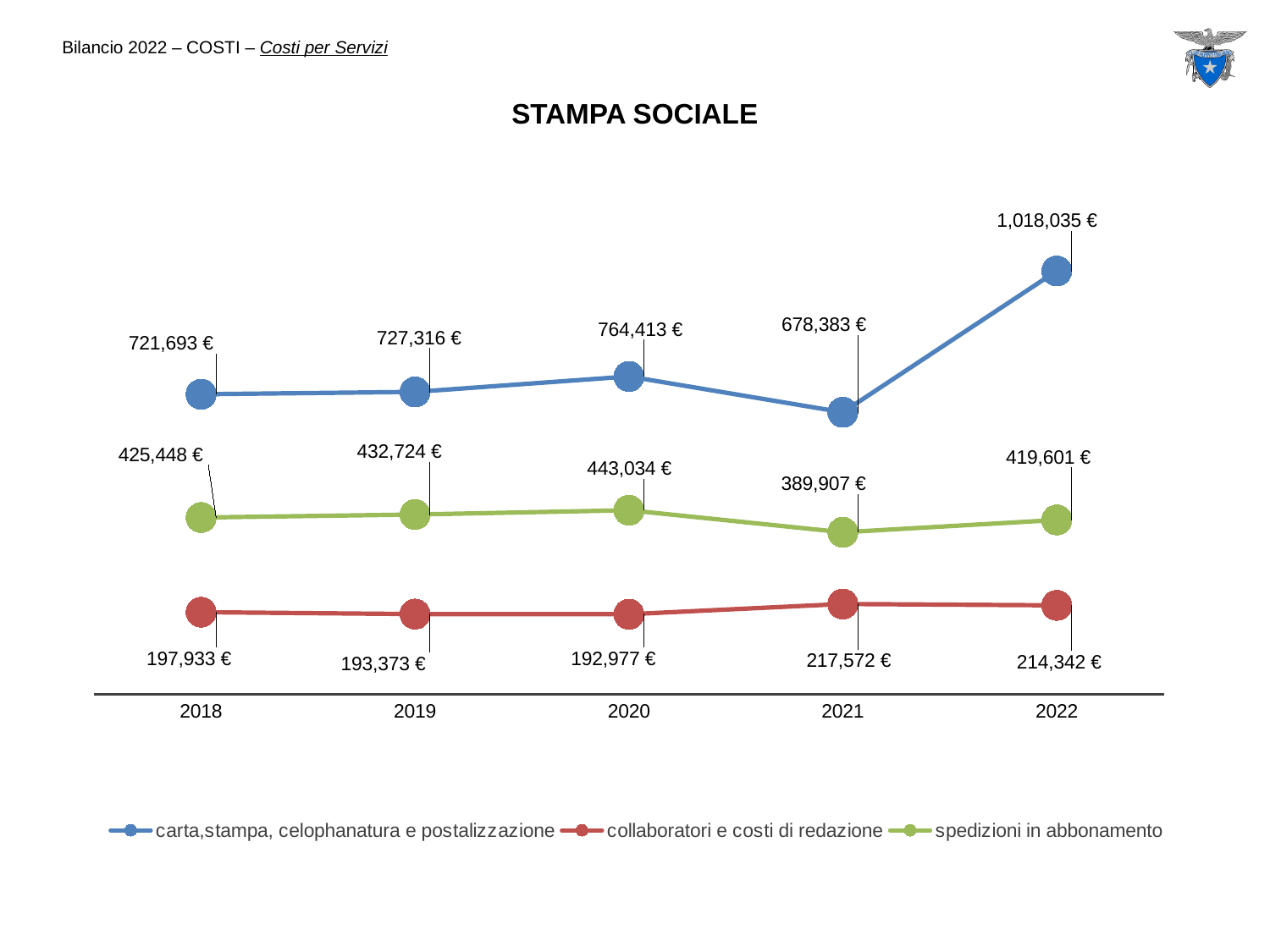
What is the difference between the 2022 and 2021 values for 'carta,stampa, celophanatura e postalizzazione'? 339,652 € Does 'carta,stampa, celophanatura e postalizzazione' rise or fall from 2021 to 2022? Rise In which year is 'carta,stampa, celophanatura e postalizzazione' at its lowest? 2021 How many years are shown on the x axis? 5 How many series does the legend list? 3 What is the value for 'collaboratori e costi di redazione' in 2019? 193,373 € In which year is 'collaboratori e costi di redazione' at its highest? 2021 Which is larger: 'spedizioni in abbonamento' in 2020 or in 2022? 2020 What is the value for 'carta,stampa, celophanatura e postalizzazione' in 2022? 1,018,035 € What is the value for 'spedizioni in abbonamento' in 2021? 389,907 € What is the title of the chart? STAMPA SOCIALE What type of chart is shown on the slide? Line chart